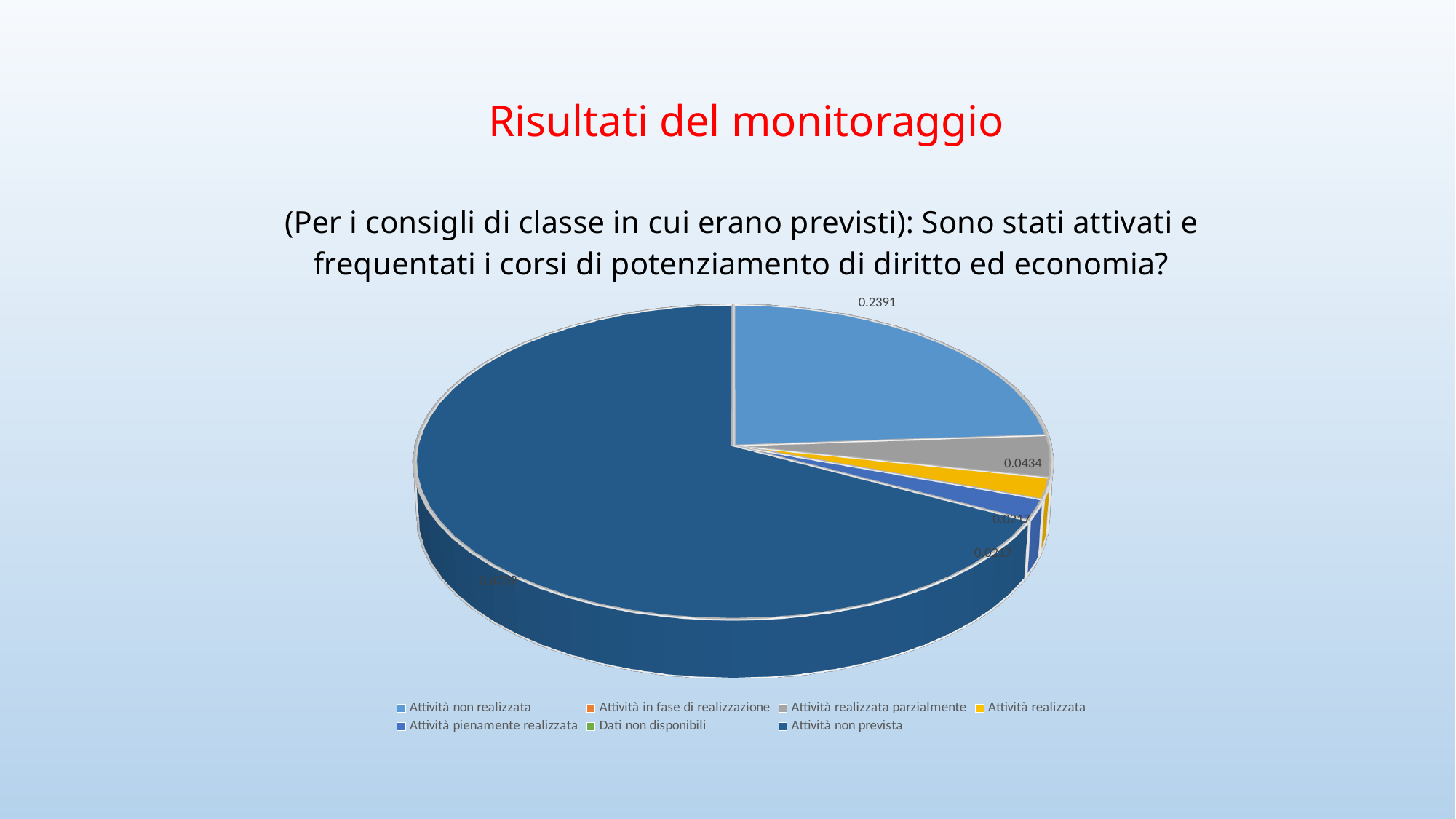
What is the value shown for 'Attività realizzata' in the pie chart? 0.0217 Which is larger in the pie chart: 'Attività realizzata parzialmente' or 'Attività realizzata'? Attività realizzata parzialmente Which is larger in the pie chart: 'Attività non realizzata' or 'Attività realizzata parzialmente'? Attività non realizzata What is the title of the pie chart? (Per i consigli di classe in cui erano previsti): Sono stati attivati e frequentati i corsi di potenziamento di diritto ed economia? What is the title of the slide? Risultati del monitoraggio What is the value shown for 'Attività realizzata parzialmente' in the pie chart? 0.0434 What is the difference between the values for 'Attività realizzata parzialmente' and 'Attività realizzata'? 0.0217 How many entries does the legend of the pie chart list? 7 What is the difference between the values for 'Attività non realizzata' and 'Attività realizzata parzialmente'? 0.1957 What is the value shown for 'Attività non realizzata' in the pie chart? 0.2391 What kind of chart is shown on the slide? pie chart Which category has the largest slice in the pie chart? Attività non prevista